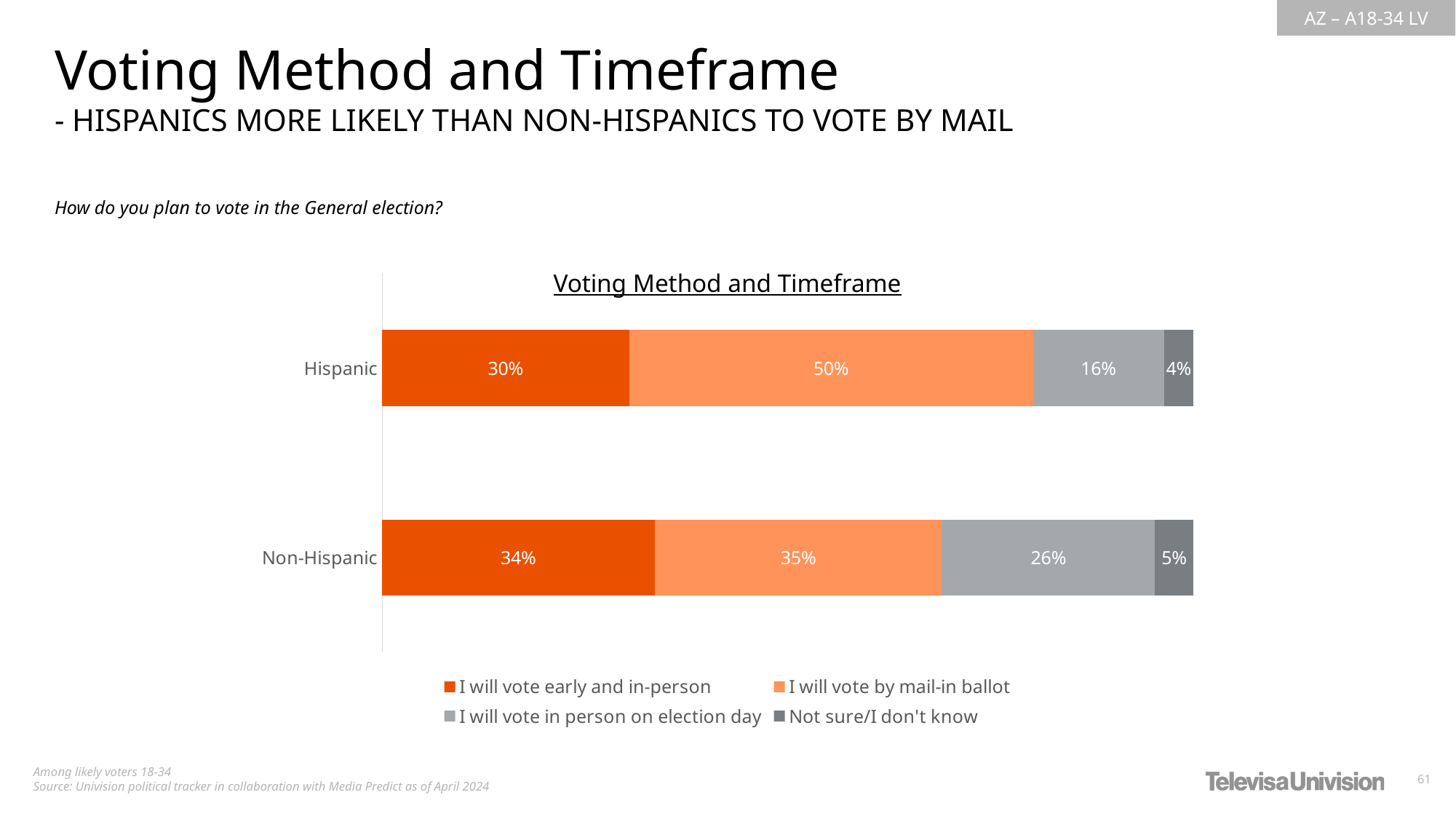
How many series does the legend list? 4 What percentage of Hispanic respondents are not sure or don't know how they will vote? 4% Which group has the higher share saying they will vote by mail-in ballot, Hispanic or Non-Hispanic? Hispanic Which response has the lowest share among Non-Hispanic respondents? Not sure/I don't know What percentage of Non-Hispanic respondents say they will vote in person on election day? 26% What is the difference between the Non-Hispanic and Hispanic shares for voting in person on election day? 10 percentage points What type of chart is shown on the slide? Stacked bar chart How many groups (categories) are shown on the chart? 2 What percentage of Hispanic respondents say they will vote by mail-in ballot? 50% Which voting method has the highest share among Hispanic respondents? I will vote by mail-in ballot What percentage of Non-Hispanic respondents say they will vote early and in-person? 34% What is the difference between the Hispanic and Non-Hispanic shares for voting by mail-in ballot? 15 percentage points